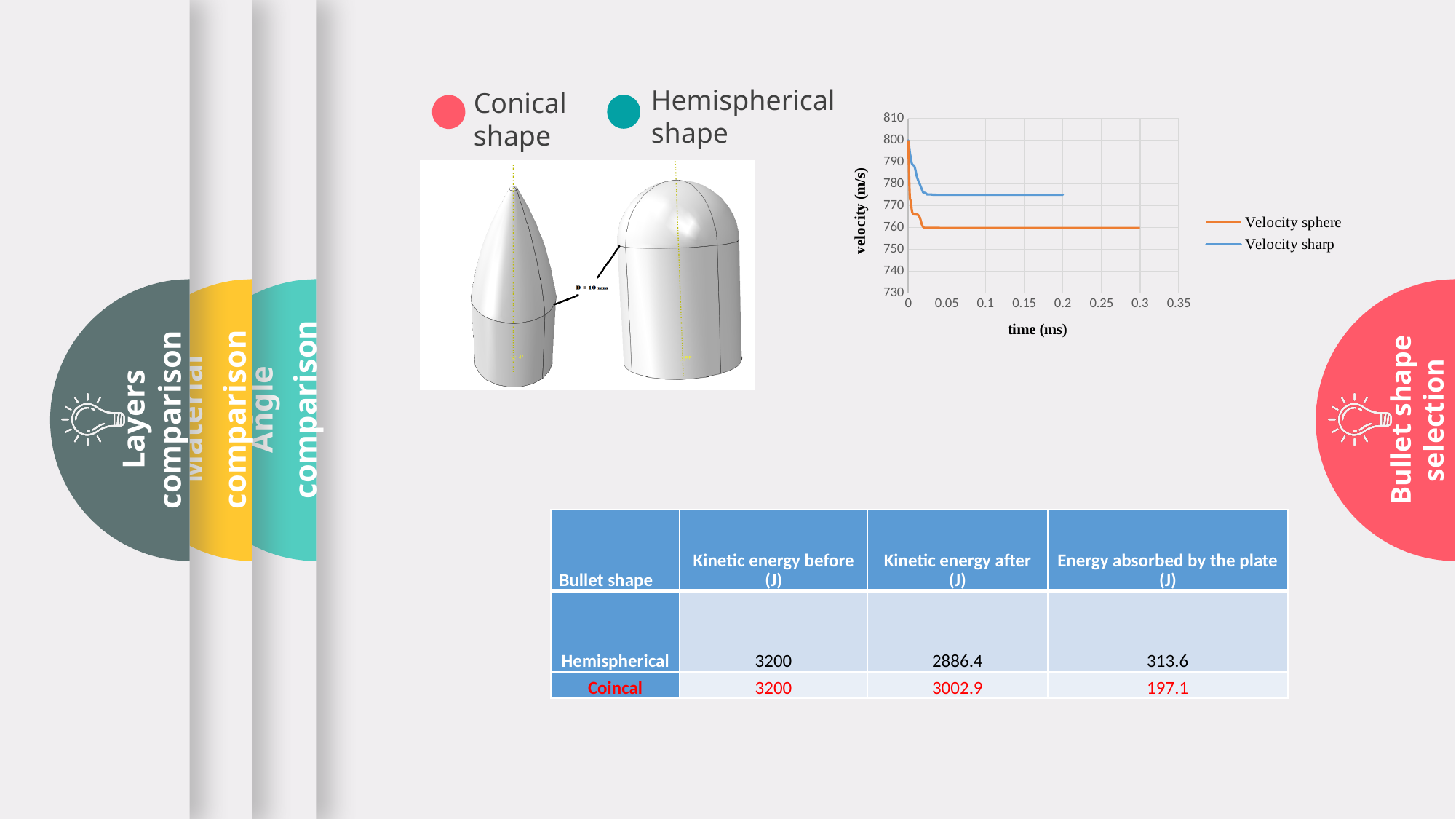
Is the starting velocity of the Velocity sphere series greater or less than 790? greater Is the plateau value of the Velocity sharp series greater or less than 770? greater What are the two series named in the chart's legend? Velocity sphere and Velocity sharp Is the final velocity of the Velocity sharp series greater or less than 780? less What is the label of the chart's y axis? velocity (m/s) Do the velocity values rise or fall along the x axis? fall Which series extends further along the time axis, Velocity sphere or Velocity sharp? Velocity sphere How many series does the chart's legend list? 2 Which series settles at a higher velocity, Velocity sphere or Velocity sharp? Velocity sharp What kind of chart is shown on the slide? line chart